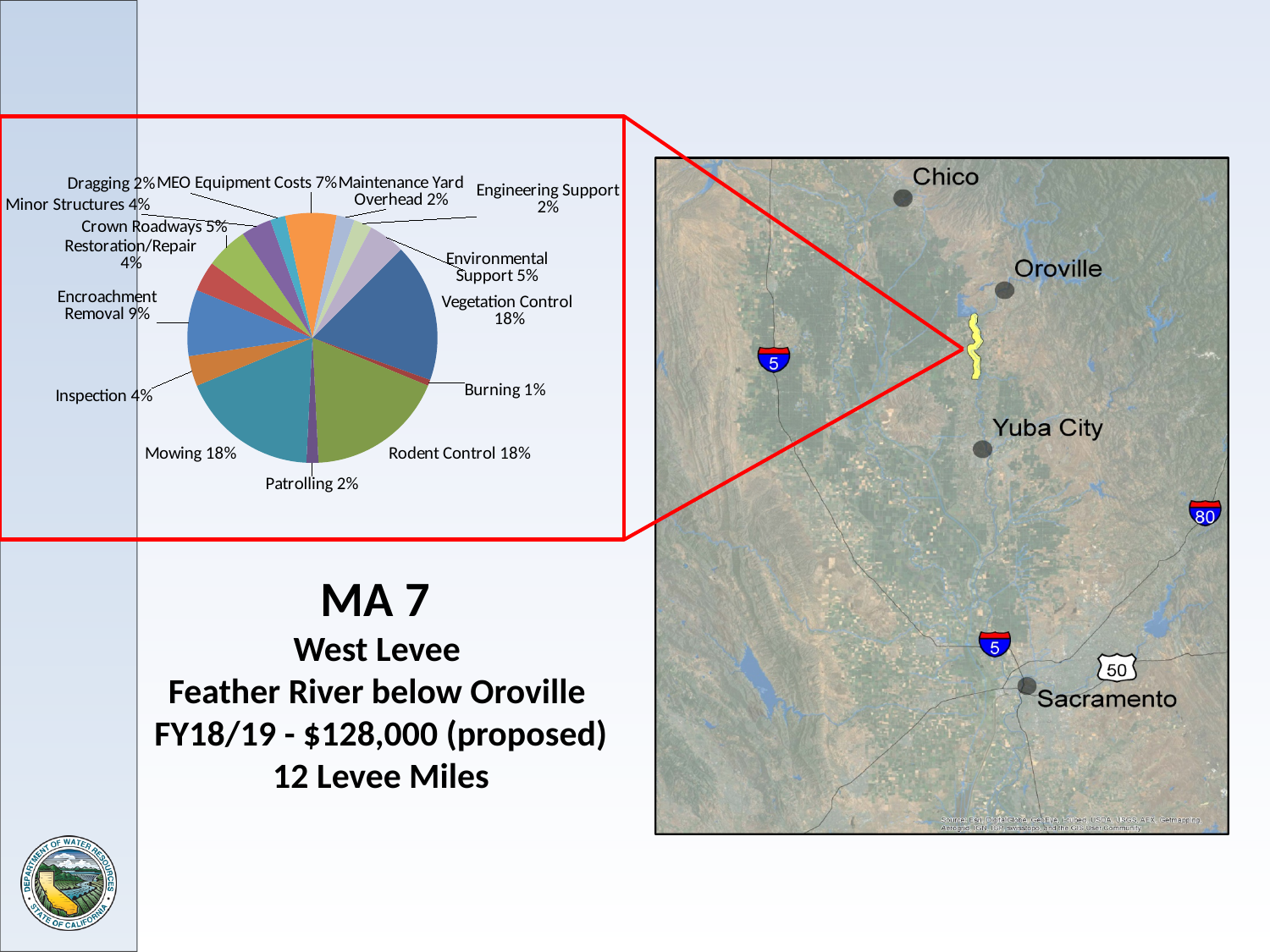
What kind of chart is shown on the slide? pie chart Which category has the smallest slice in the pie chart? Burning What percentage is shown for Patrolling? 2% What share of the pie does Mowing represent? 18% What is the difference in percentage points between Encroachment Removal and Crown Roadways? 4 What is the value shown for MEO Equipment Costs in the pie chart? 7% Which is larger in the pie chart, Rodent Control or Encroachment Removal? Rodent Control What percentage of the pie chart is Vegetation Control? 18% How many categories are labelled in the pie chart? 15 What is the difference in percentage points between Mowing and Inspection? 14 What percentage does Encroachment Removal account for in the pie chart? 9% What percentage is shown for Environmental Support? 5%